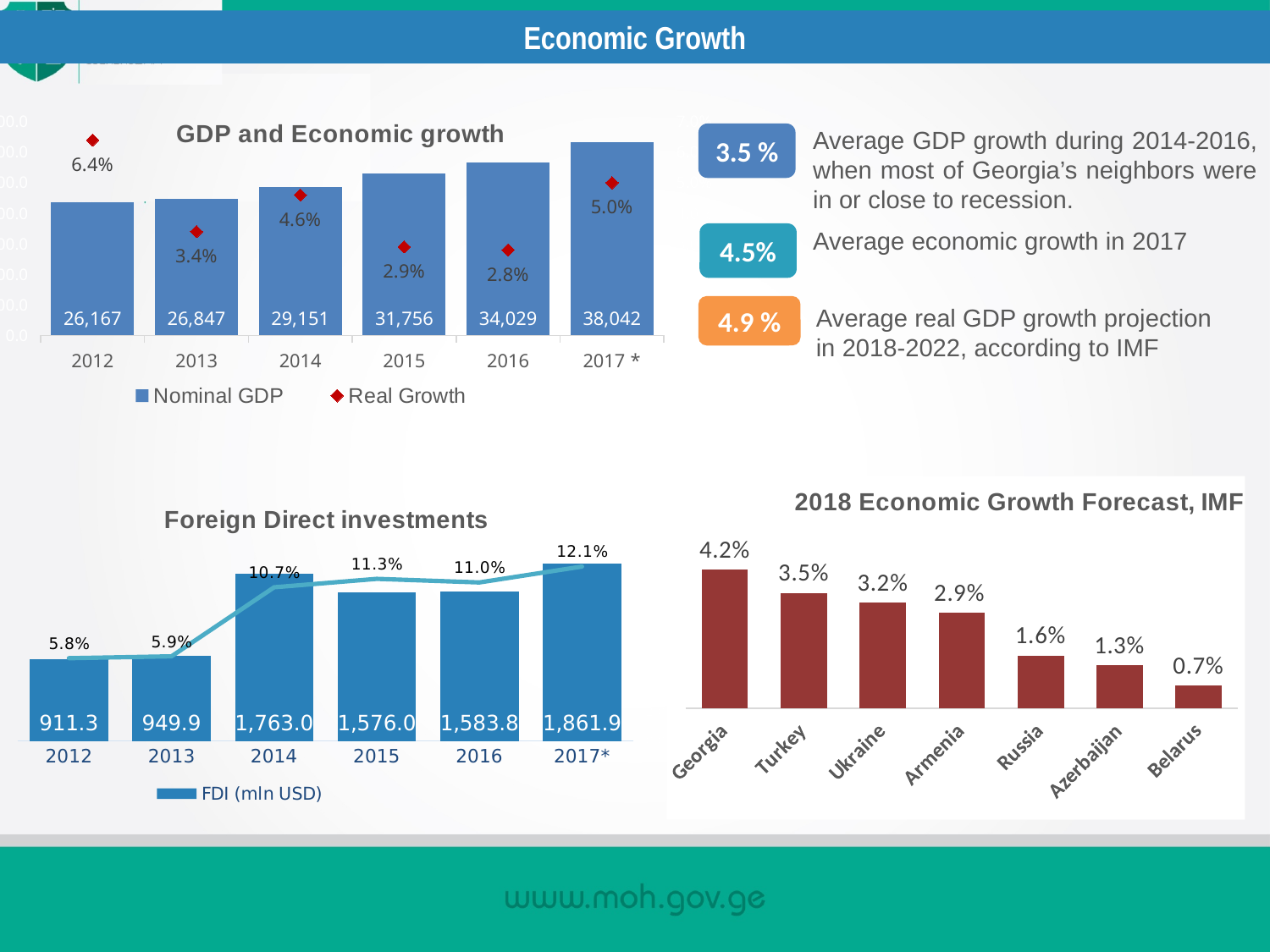
In the 'Foreign Direct investments' chart, which year has the highest FDI (mln USD) value? 2017* In the 'GDP and Economic growth' chart, what is the Nominal GDP value for 2015? 31,756 In the 'GDP and Economic growth' chart, which year has the lowest Real Growth? 2016 In the '2018 Economic Growth Forecast, IMF' chart, how many countries are shown? 7 In the 'GDP and Economic growth' chart, what is the Real Growth value for 2012? 6.4% In the 'Foreign Direct investments' chart, is the FDI value for 2015 larger or smaller than the value for 2016? smaller In the '2018 Economic Growth Forecast, IMF' chart, what is the value for Armenia? 2.9% In the '2018 Economic Growth Forecast, IMF' chart, what is the difference between the values for Georgia and Belarus? 3.5% In the 'GDP and Economic growth' chart, do the Nominal GDP values rise or fall from 2012 to 2017 *? rise In the 'GDP and Economic growth' chart, how many series does the legend list? 2 In the 'Foreign Direct investments' chart, what is the FDI (mln USD) value for 2014? 1,763.0 In the 'GDP and Economic growth' chart, what is the difference in Nominal GDP between 2017 * and 2016? 4,013